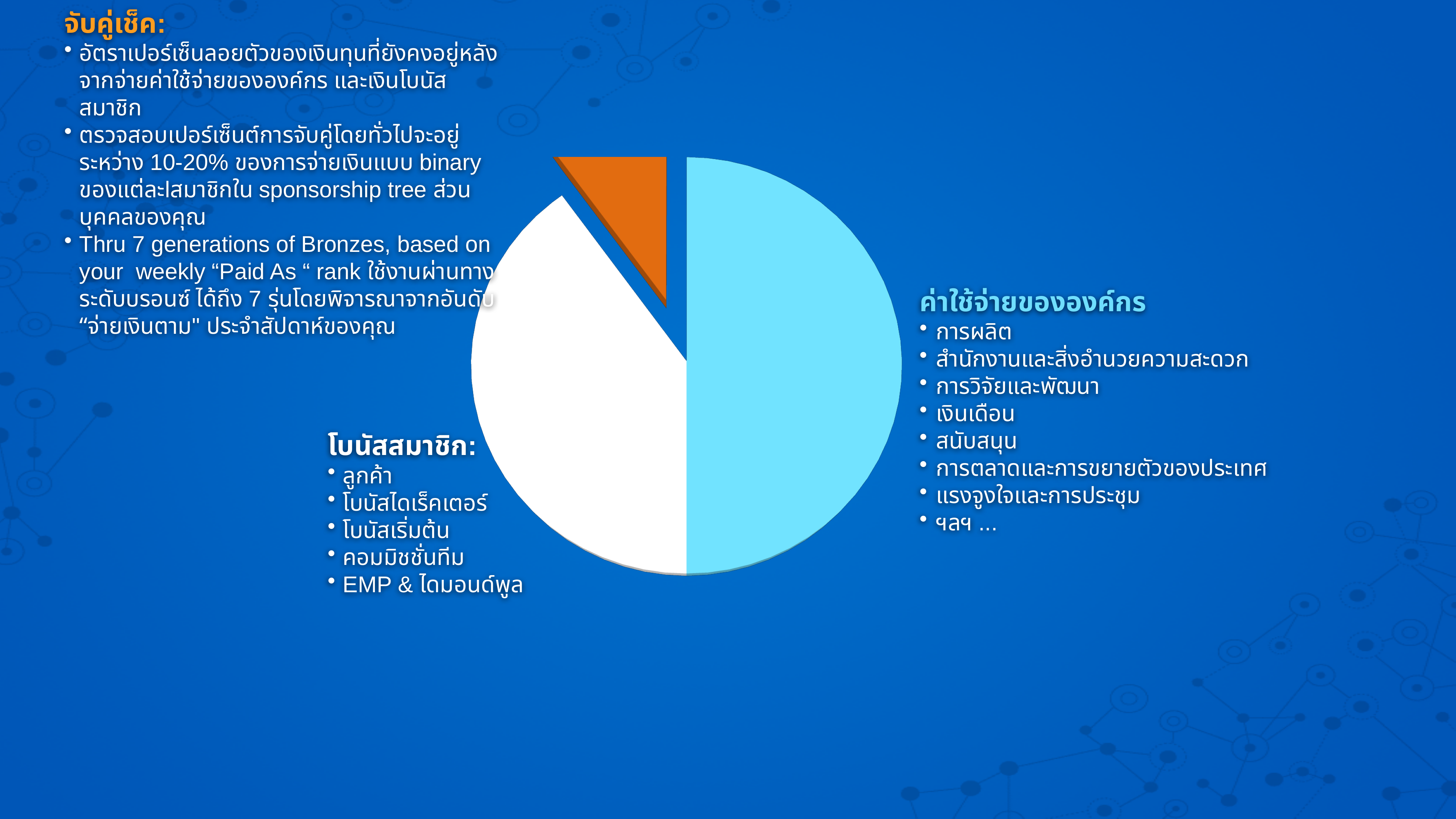
What colour is the smallest slice of the pie chart? orange Which is larger in the pie chart, the light blue slice or the orange slice? the light blue slice Which slice of the pie chart is the smallest? the orange slice Which slice of the pie chart is the largest? the light blue slice What colour is the largest slice of the pie chart? light blue Which is larger in the pie chart, the light blue slice or the white slice? the light blue slice What kind of chart is shown on the slide? pie chart How many slices does the pie chart have? 3 Which is larger in the pie chart, the white slice or the orange slice? the white slice